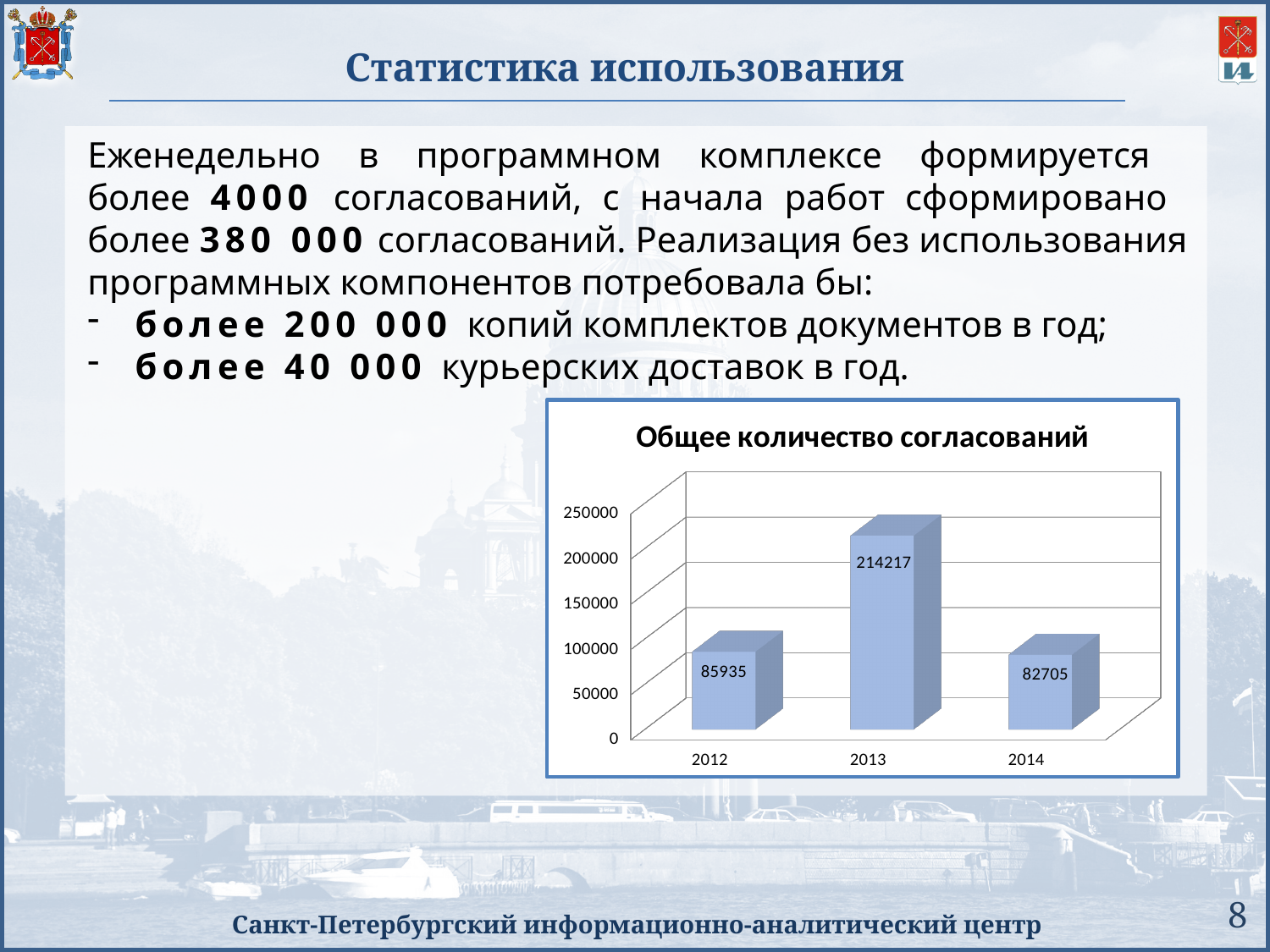
How many years are shown on the x axis of the chart? 3 What is the value for 2013 in the chart? 214217 What is the title of the chart? Общее количество согласований Is the value for 2013 greater or less than 200000? greater What is the value for 2014 in the chart? 82705 What is the difference between the values for 2013 and 2012? 128282 Which year has the lowest value in the chart? 2014 What is the value for 2012 in the chart? 85935 Does the value rise or fall from 2013 to 2014? fall Which year has the highest value in the chart? 2013 What type of chart is shown on the slide? bar chart What is the difference between the values for 2012 and 2014? 3230